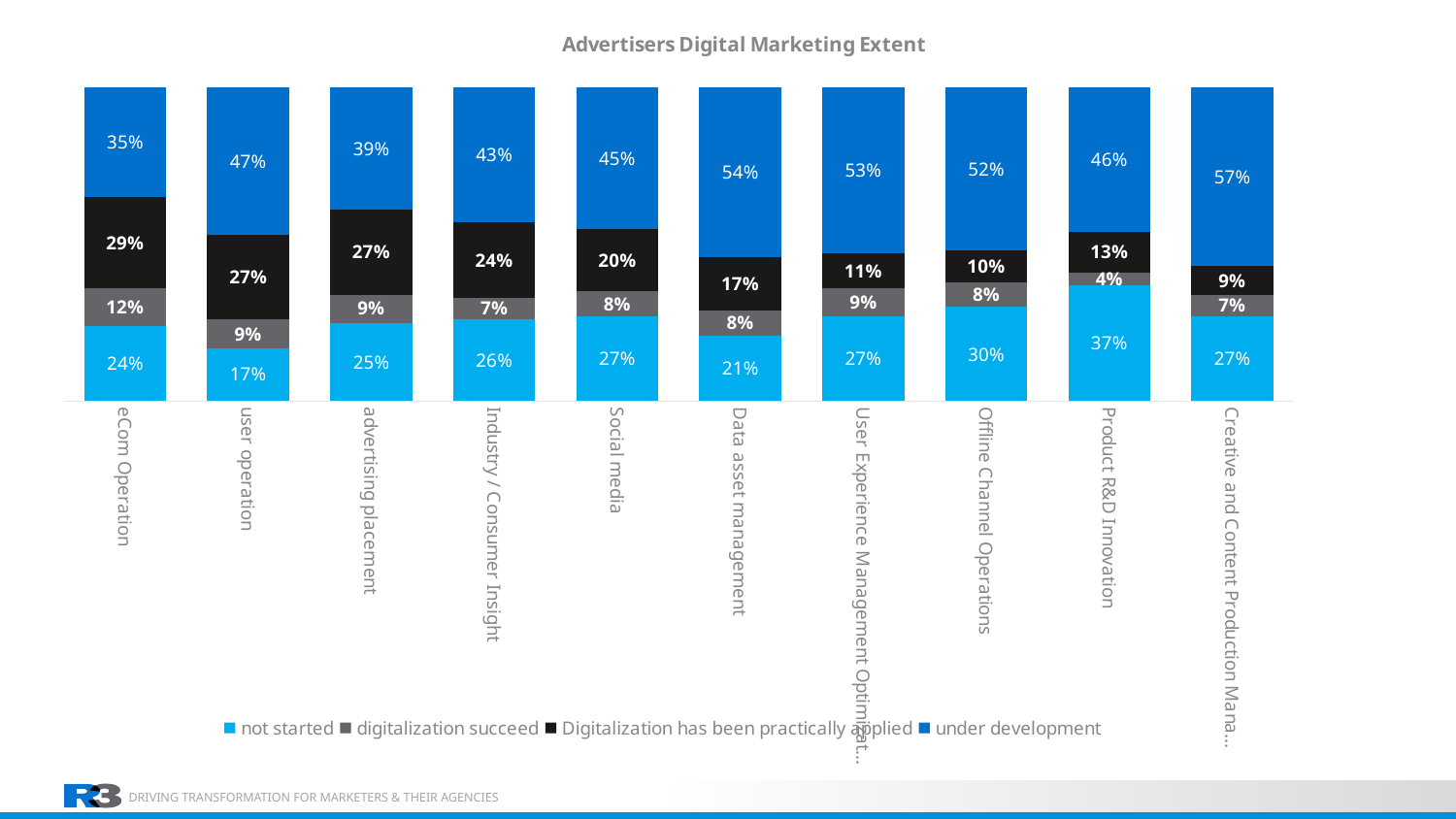
Which is larger: the 'not started' value for Offline Channel Operations or for Social media? Offline Channel Operations Which category has the lowest 'not started' value? user operation What is the 'under development' value for Data asset management? 54% How many categories are shown on the x axis? 10 What kind of chart is shown on the slide? Stacked bar chart What is the 'Digitalization has been practically applied' value for eCom Operation? 29% What is the title of the chart? Advertisers Digital Marketing Extent What is the 'digitalization succeed' value for Industry / Consumer Insight? 7% How many series does the legend list? 4 What is the 'not started' value for Product R&D Innovation? 37% Which category has the highest 'Digitalization has been practically applied' value? eCom Operation What is the difference between the 'under development' values for Social media and eCom Operation? 10%